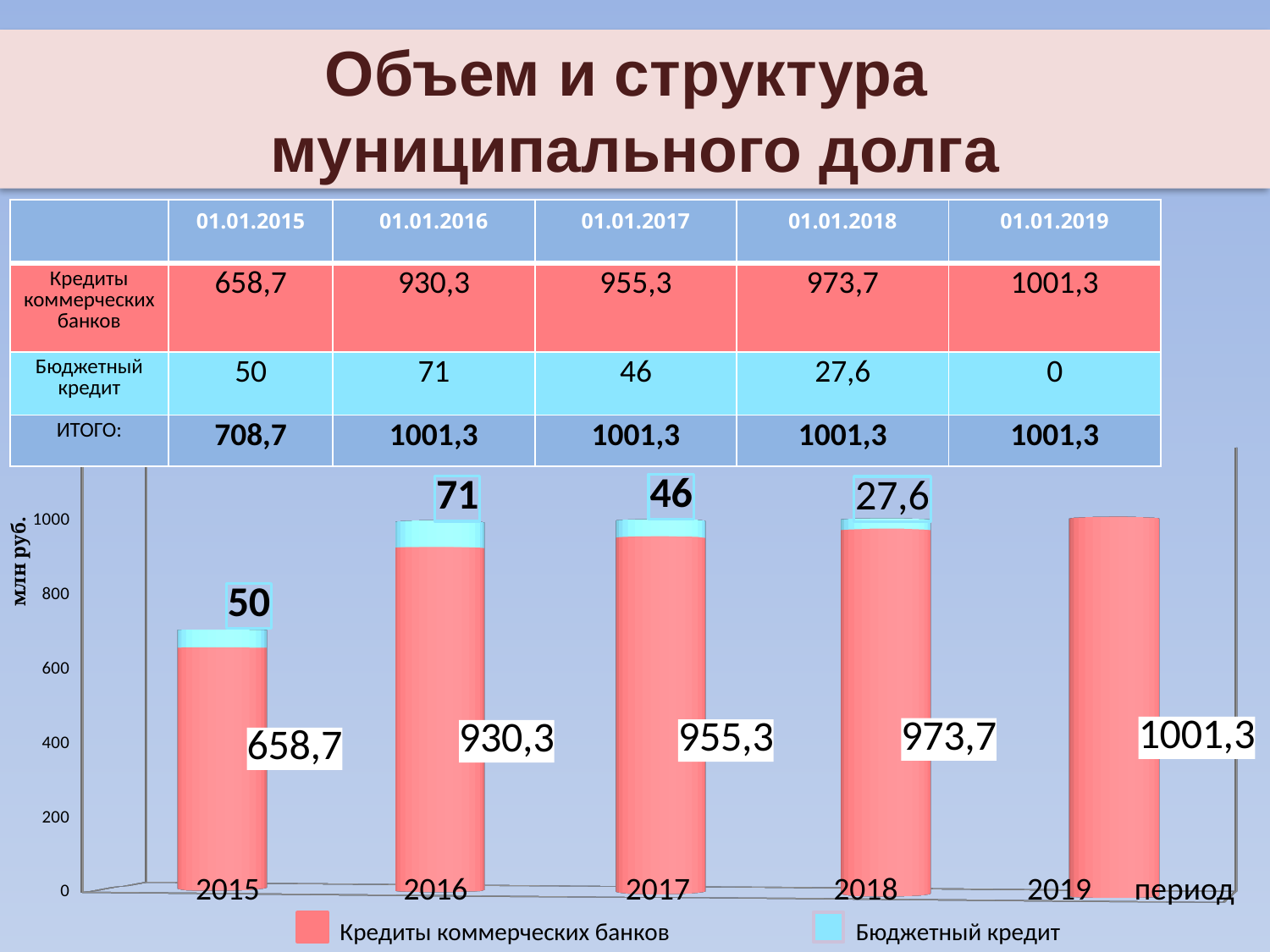
What is the value of Кредиты коммерческих банков for 2015? 658,7 Do the Кредиты коммерческих банков values rise or fall from 2015 to 2019? Rise How many series does the chart legend list? 2 What is the value of Кредиты коммерческих банков for 2019? 1001,3 What type of chart is shown on the slide? Stacked bar chart What is the total of the stacked bar for 2015? 708,7 What is the value of Бюджетный кредит for 2016? 71 In which year is the Кредиты коммерческих банков value lowest? 2015 What is the difference between the Кредиты коммерческих банков values for 2016 and 2015? 271,6 How many periods (years) are shown on the x axis of the chart? 5 In which year is the Бюджетный кредит value highest? 2016 Which is larger: the Бюджетный кредит value for 2017 or for 2018? 2017